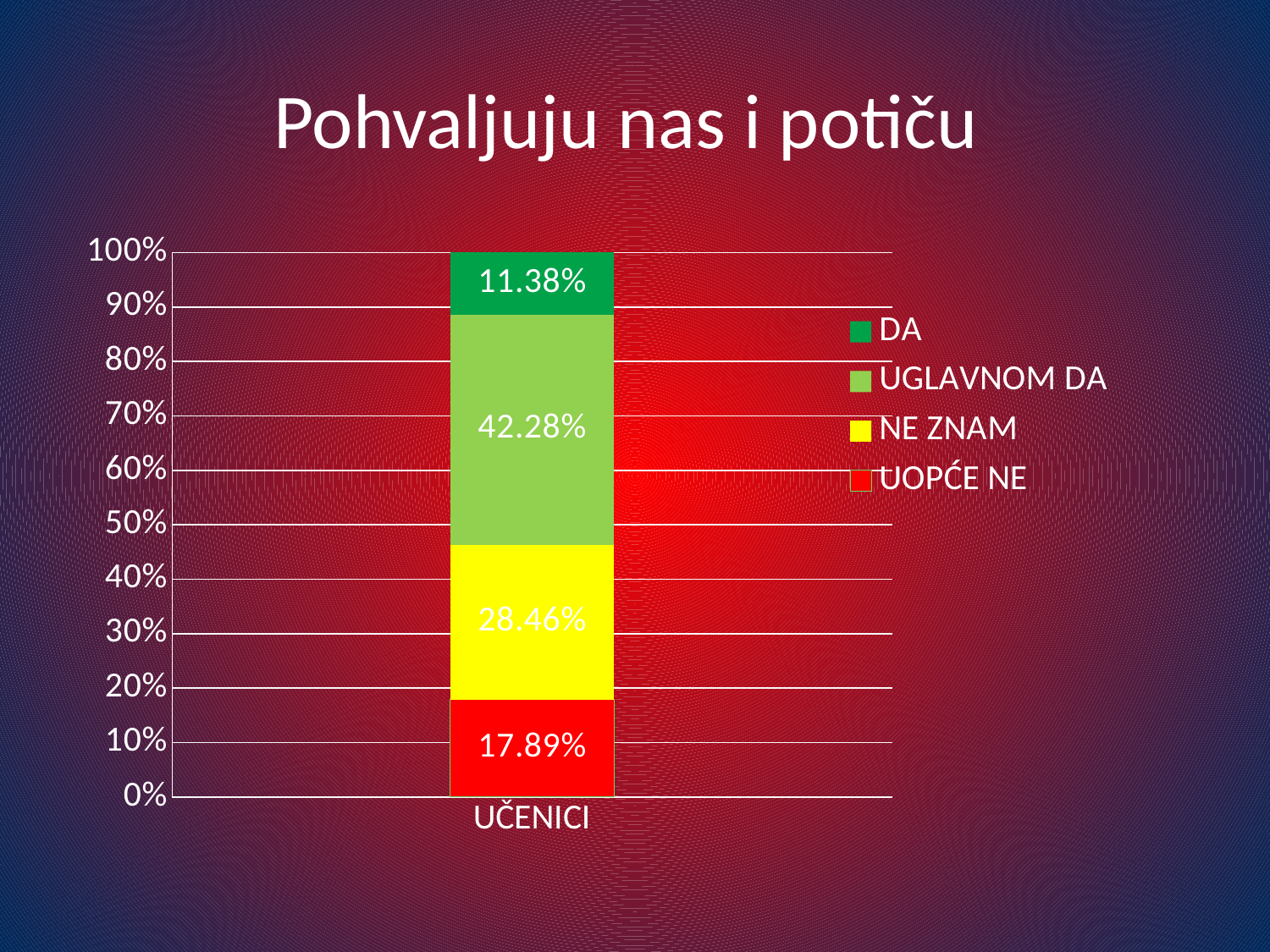
How many categories are shown on the x axis? 1 Which series has the lowest value in the UČENICI bar? DA What is the value for UGLAVNOM DA in the UČENICI bar? 42.28% How many series does the legend list? 4 What is the title of the slide? Pohvaljuju nas i potiču What is the difference between the UGLAVNOM DA and NE ZNAM values? 13.82% What is the value for DA in the UČENICI bar? 11.38% Which is larger, the value for NE ZNAM or the value for UOPĆE NE? NE ZNAM What kind of chart is shown on the slide? Stacked bar chart Which series has the highest value in the UČENICI bar? UGLAVNOM DA What is the value for NE ZNAM in the UČENICI bar? 28.46% What is the value for UOPĆE NE in the UČENICI bar? 17.89%